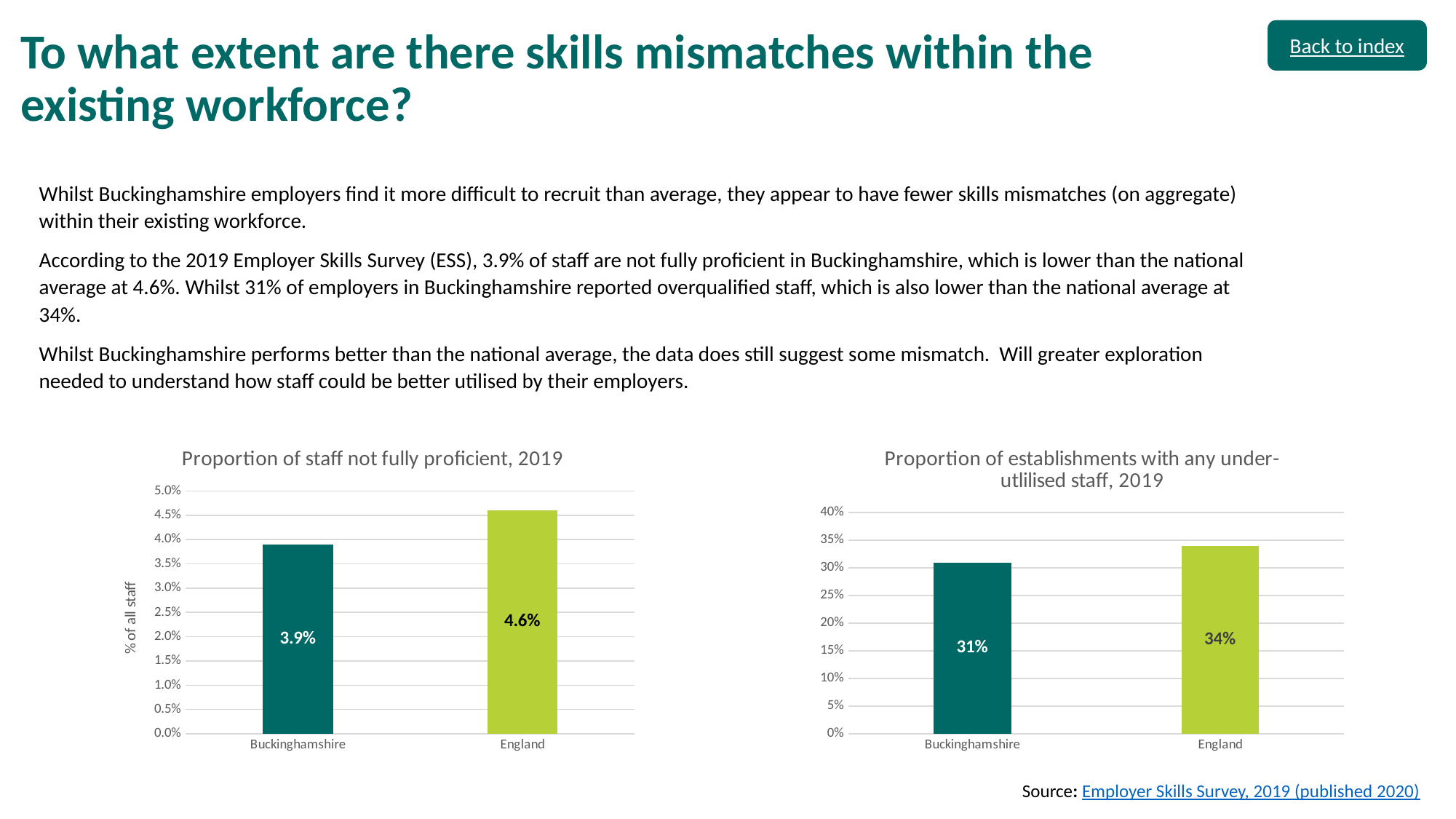
What is the y-axis label of the 'Proportion of staff not fully proficient, 2019' chart? % of all staff In the 'Proportion of staff not fully proficient, 2019' chart, what is the difference between the England and Buckinghamshire values? 0.7% What kind of chart is the 'Proportion of establishments with any under-utlilised staff, 2019' chart? Bar chart In the 'Proportion of establishments with any under-utlilised staff, 2019' chart, what is the difference between the England and Buckinghamshire values? 3% In the 'Proportion of establishments with any under-utlilised staff, 2019' chart, what is the value for Buckinghamshire? 31% In the 'Proportion of staff not fully proficient, 2019' chart, what is the value for England? 4.6% In the 'Proportion of staff not fully proficient, 2019' chart, which category has the highest value? England How many categories are shown in the 'Proportion of staff not fully proficient, 2019' chart? 2 In the 'Proportion of establishments with any under-utlilised staff, 2019' chart, is the value for Buckinghamshire greater or less than 35%? less In the 'Proportion of staff not fully proficient, 2019' chart, what is the value for Buckinghamshire? 3.9% In the 'Proportion of establishments with any under-utlilised staff, 2019' chart, which category has the lowest value? Buckinghamshire In the 'Proportion of establishments with any under-utlilised staff, 2019' chart, what is the value for England? 34%